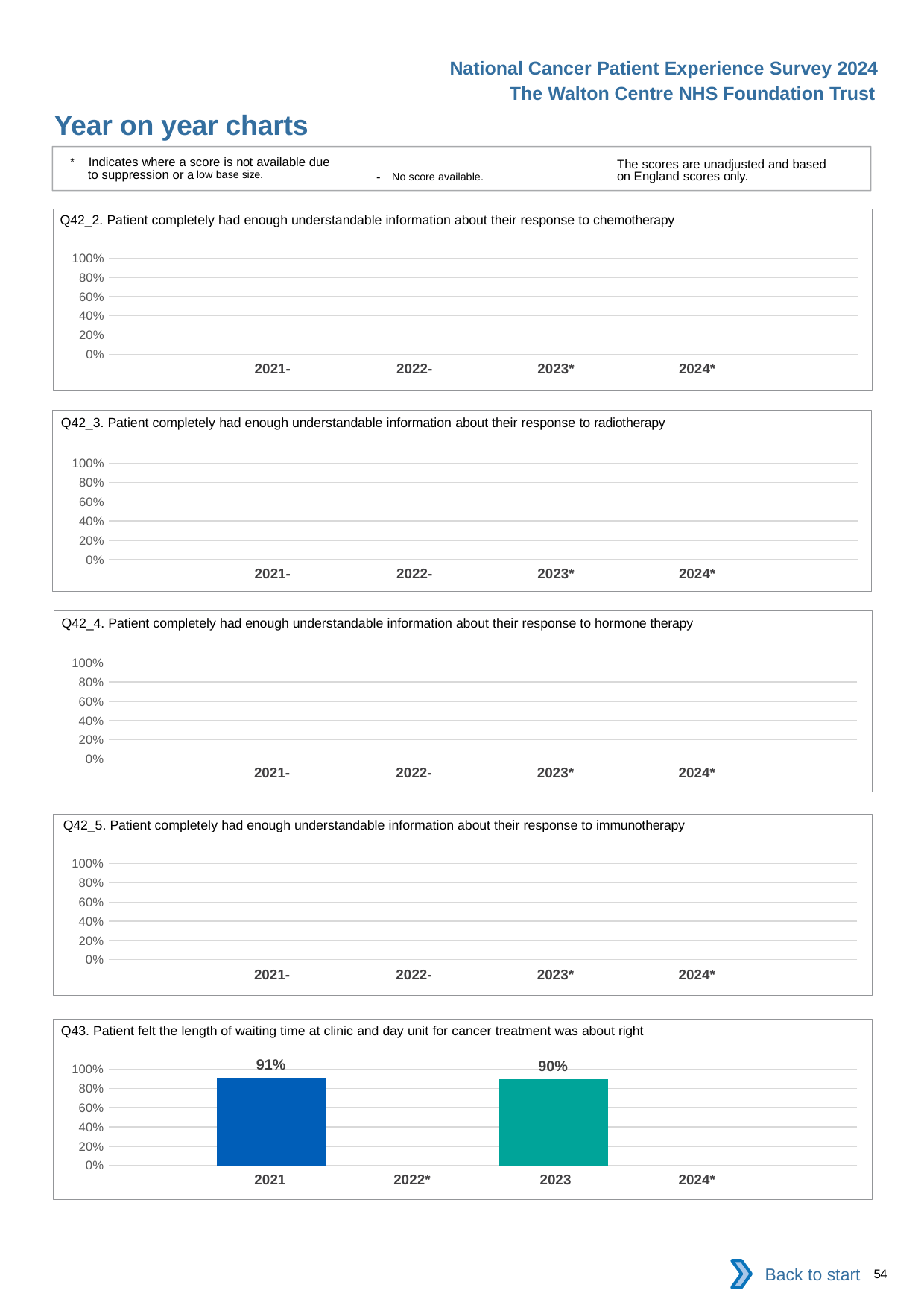
In the Q43 chart, which years are marked with an asterisk indicating no available score? 2022* and 2024* In the Q43 chart, how many years have a bar plotted? 2 In the Q43 chart, how many year categories are shown on the x axis? 4 In the Q43 chart, what is the value for 2021? 91% In the Q42_2 chart, how many year categories are shown on the x axis? 4 In the Q43 chart, what is the value for 2023? 90% What kind of chart is the Q43 chart? bar chart In the Q43 chart, which year has the highest value? 2021 In the Q43 chart, what is the difference between the 2021 and 2023 values? 1% In the Q43 chart, is the value for 2021 greater or less than 80%? greater What is the title of the bottom chart on the slide? Q43. Patient felt the length of waiting time at clinic and day unit for cancer treatment was about right